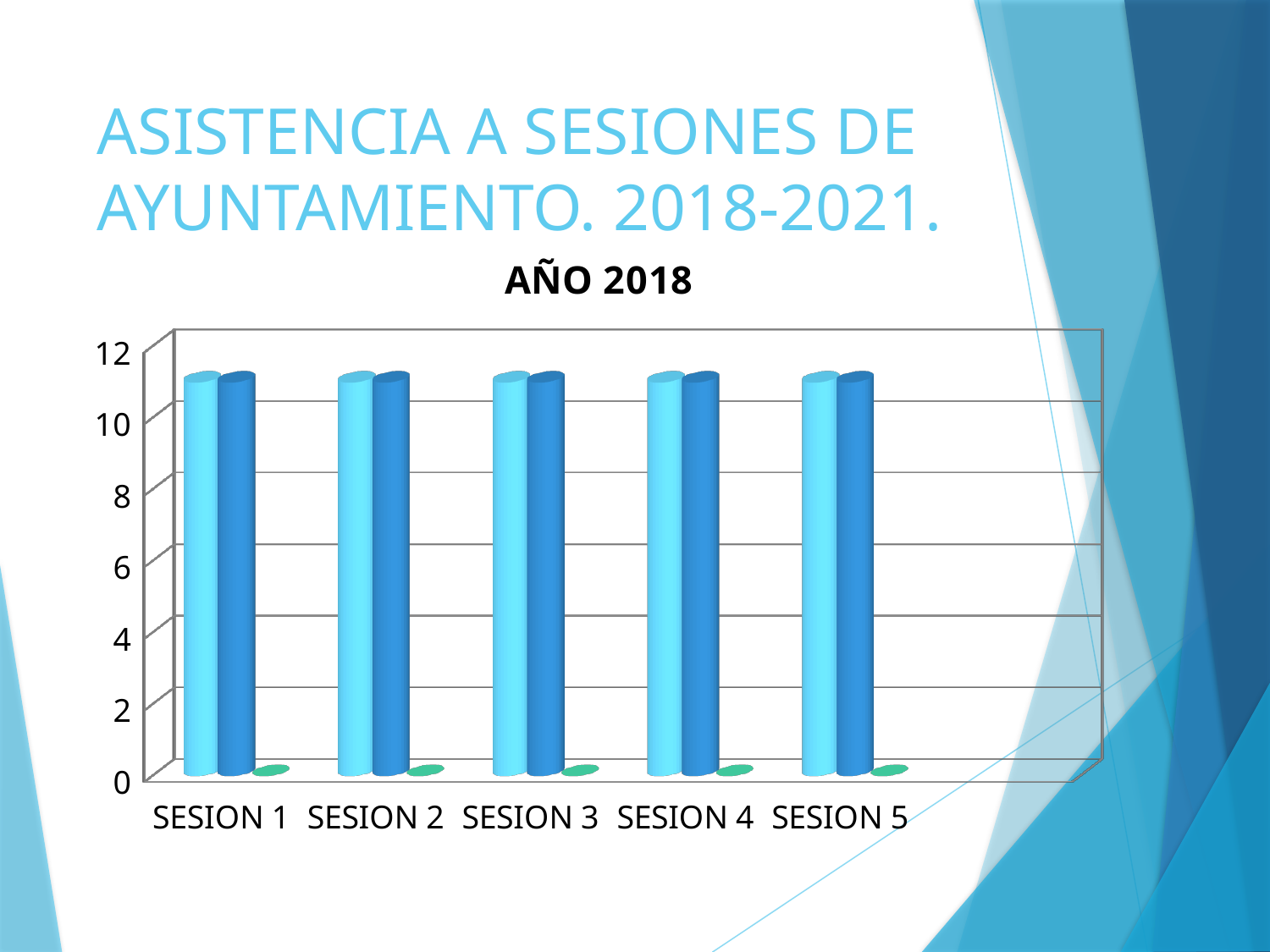
Is the value of the dark blue bar for SESION 3 greater or less than 12? less What kind of chart is shown on the slide? bar chart What is the value of the green series for SESION 4? 0 What is the label of the first category on the x axis? SESION 1 Is the value of the dark blue bar for SESION 2 greater or less than 10? greater What is the title of the chart? AÑO 2018 Is the value of the light blue bar for SESION 1 greater or less than 10? greater How many categories (sessions) are shown on the x axis of the chart? 5 Which series has the lowest values across all sessions: the light blue, the dark blue, or the green? green Do the light blue bar values rise, fall, or stay the same from SESION 1 to SESION 5? stay the same